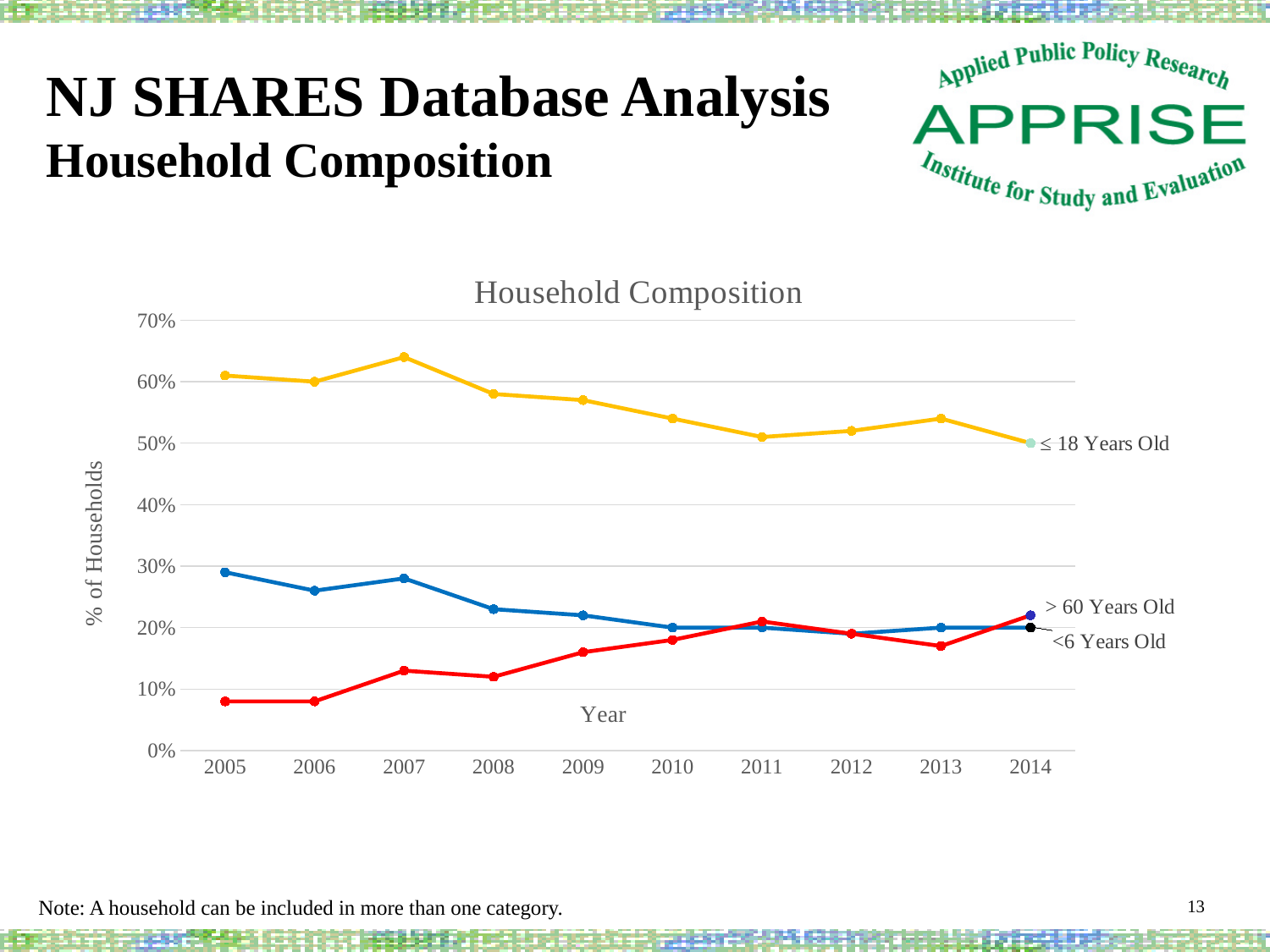
How many series are plotted in the Household Composition chart? 3 Is the value for ≤ 18 Years Old in 2011 greater or less than 60%? less Which series has the highest value in 2005? ≤ 18 Years Old What is the value for ≤ 18 Years Old in 2014? 50% In which year does the ≤ 18 Years Old series reach its lowest value? 2014 How many years are plotted along the x axis of the Household Composition chart? 10 What kind of chart is shown on the slide? line chart What is the title of the y axis of the chart? % of Households In which year does the ≤ 18 Years Old series reach its highest value? 2007 Does the ≤ 18 Years Old series generally rise or fall from 2005 to 2014? fall What is the value for ≤ 18 Years Old in 2006? 60% Is the value for ≤ 18 Years Old in 2007 greater or less than 60%? greater